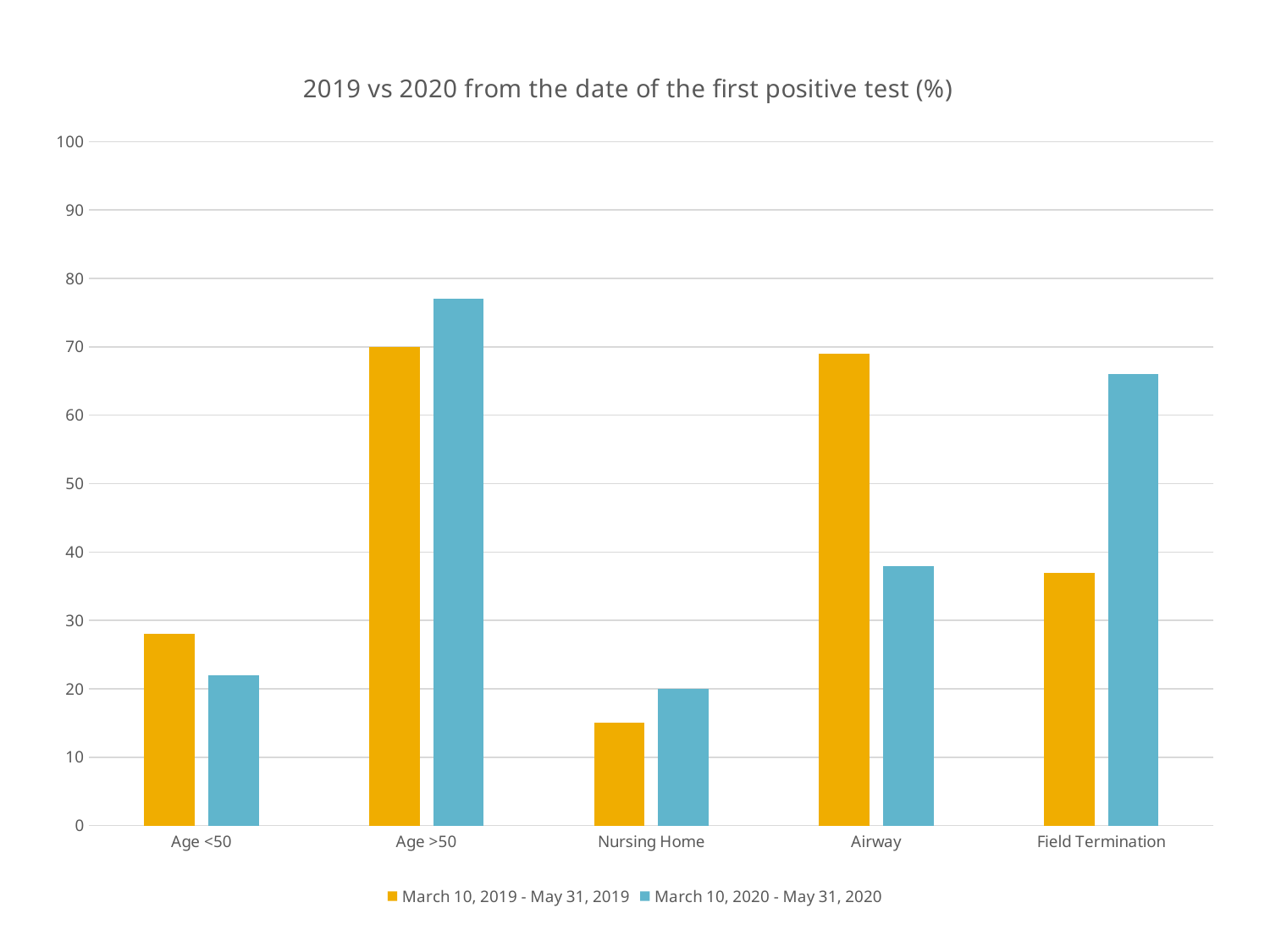
For Airway, which series has the larger value: March 10, 2019 - May 31, 2019 or March 10, 2020 - May 31, 2020? March 10, 2019 - May 31, 2019 Is the value for Field Termination in the March 10, 2020 - May 31, 2020 series greater or less than 60? greater For Field Termination, which series has the larger value: March 10, 2019 - May 31, 2019 or March 10, 2020 - May 31, 2020? March 10, 2020 - May 31, 2020 Which category has the highest value for the March 10, 2020 - May 31, 2020 series? Age >50 Is the value for Age <50 in the March 10, 2019 - May 31, 2019 series greater or less than 30? less Which category has the lowest value for the March 10, 2019 - May 31, 2019 series? Nursing Home How many series does the legend list? 2 Is the value for Airway in the March 10, 2020 - May 31, 2020 series greater or less than 40? less What kind of chart is shown on the slide? bar chart How many categories are shown on the x axis? 5 What is the title of the chart? 2019 vs 2020 from the date of the first positive test (%)